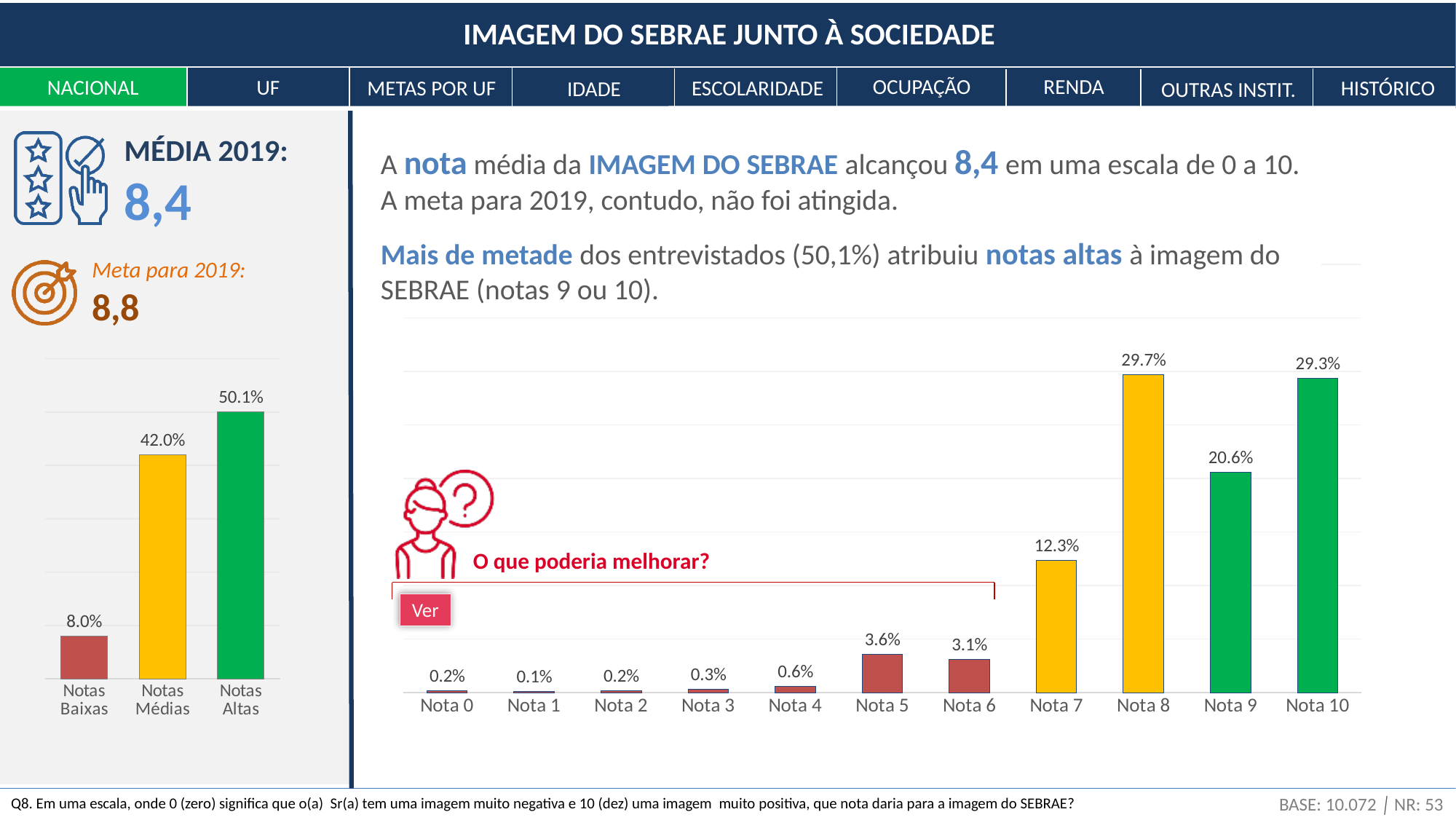
In the chart on the left, what is the value for Notas Baixas? 8.0% In the chart on the right, which category has the lowest value? Nota 1 In the chart on the right, which is larger, Nota 5 or Nota 6? Nota 5 In the chart on the left, what is the difference between Notas Altas and Notas Médias? 8.1% In the chart on the right, how many categories are shown? 11 In the chart on the right, what is the value for Nota 8? 29.7% In the chart on the left, how many categories are shown? 3 What type of chart is the chart on the right? Bar chart In the chart on the left, what is the value for Notas Altas? 50.1% In the chart on the right, what is the value for Nota 7? 12.3% In the chart on the left, which category has the highest value? Notas Altas In the chart on the right, what is the difference between Nota 10 and Nota 9? 8.7%